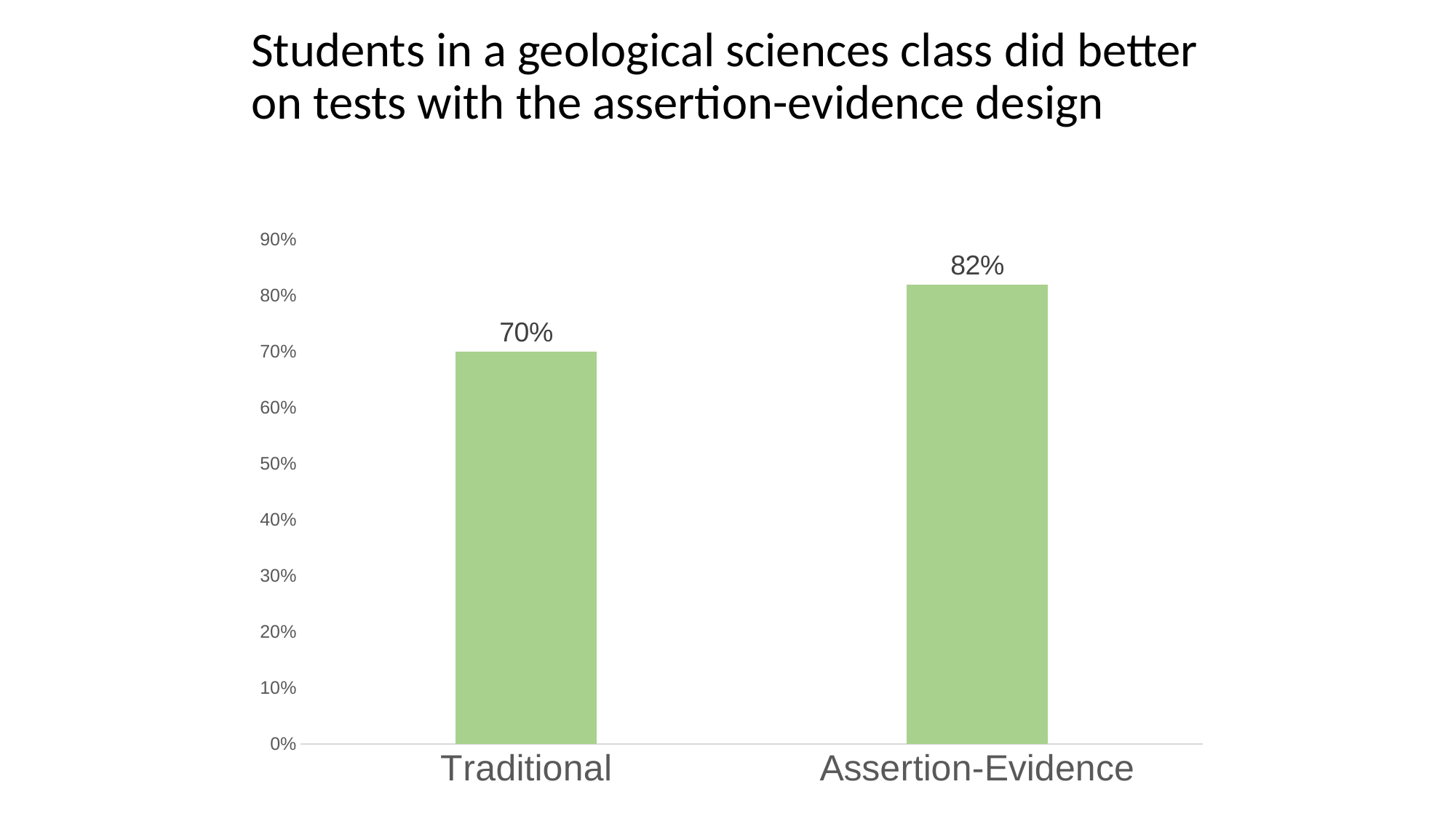
Do the values rise or fall from Traditional to Assertion-Evidence? rise What is the value for Assertion-Evidence? 82% What colour are the bars in the chart? green What kind of chart is shown on the slide? bar chart Is the value for Traditional greater or less than 80%? less Is the value for Assertion-Evidence greater or less than 80%? greater What is the value for Traditional? 70% How many categories are shown on the chart? 2 Which is larger, the value for Traditional or the value for Assertion-Evidence? Assertion-Evidence Which category has the lowest value? Traditional Which category has the highest value? Assertion-Evidence What is the difference between the values for Assertion-Evidence and Traditional? 12%